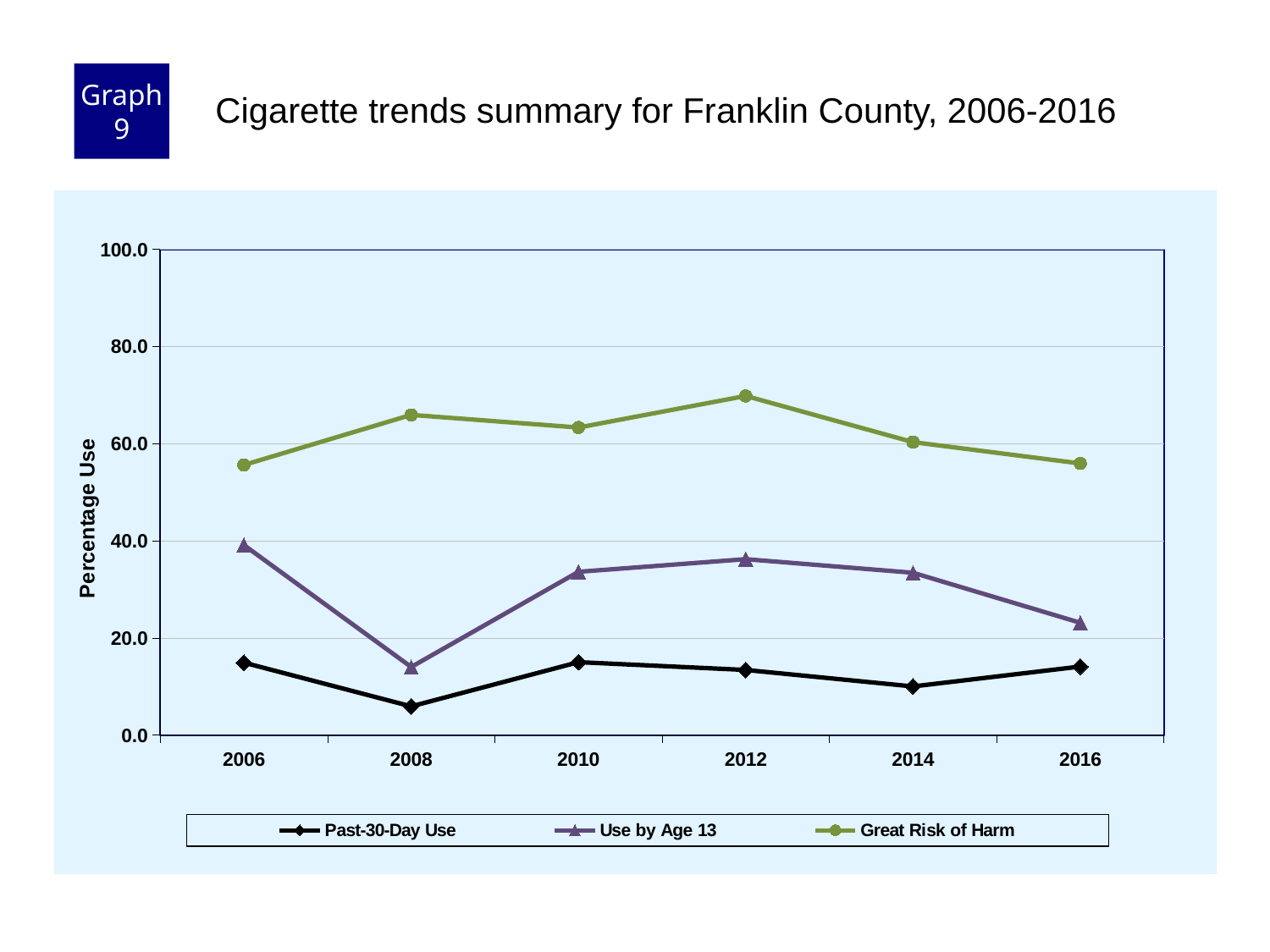
In which year is the Past-30-Day Use value lowest? 2008 Is the Past-30-Day Use value for 2010 greater or less than 20.0? less Does the Use by Age 13 line rise or fall from 2012 to 2016? Fall How many series does the legend list? 3 Is the Great Risk of Harm value for 2012 greater or less than 60.0? greater In which year is the Great Risk of Harm value highest? 2012 In which year is the Use by Age 13 value lowest? 2008 In 2012, which is larger: Great Risk of Harm or Use by Age 13? Great Risk of Harm How many years are plotted along the x axis? 6 What is the label on the y axis? Percentage Use Is the Use by Age 13 value for 2008 greater or less than 20.0? less What kind of chart is shown on the slide? Line chart